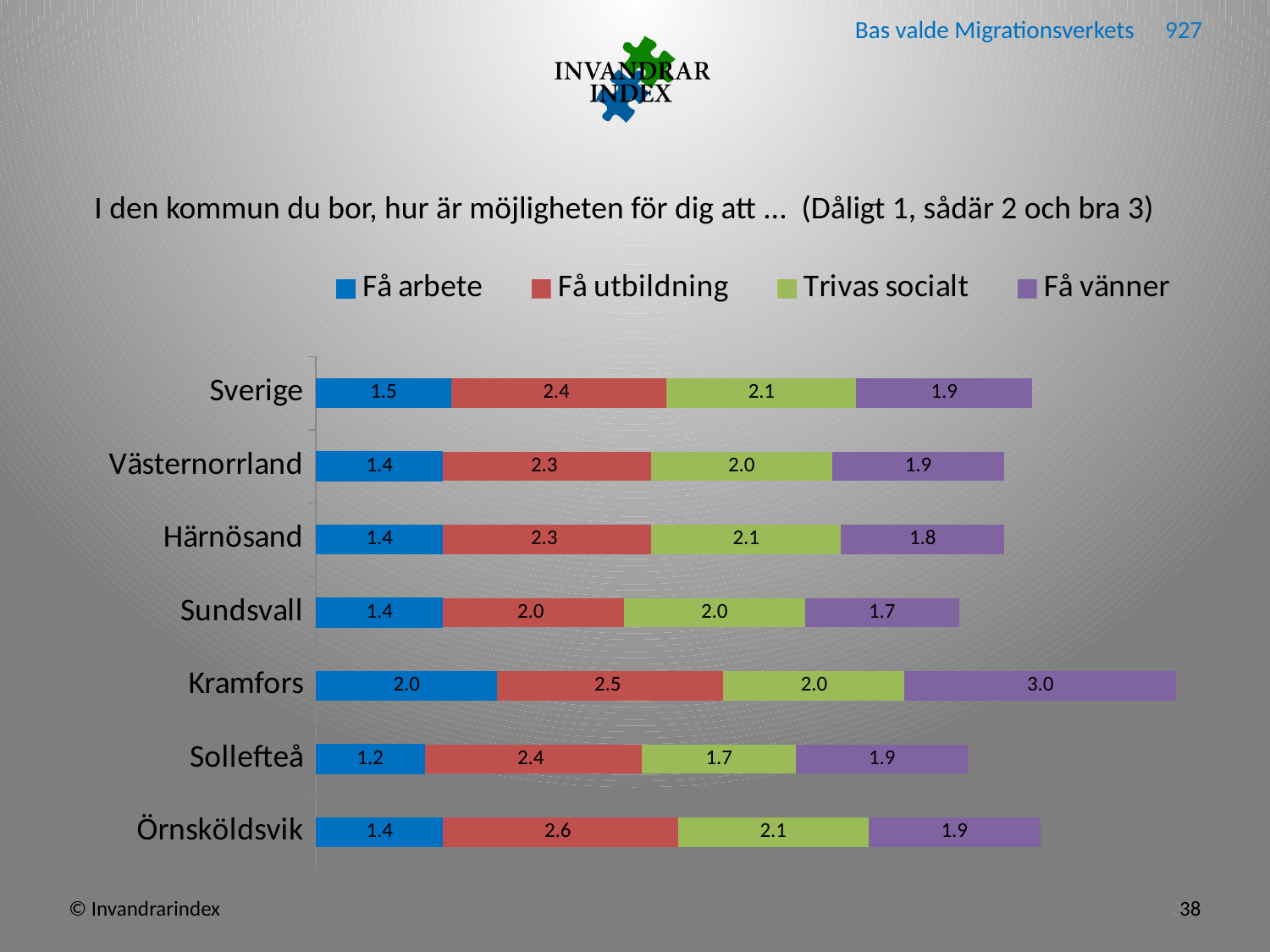
What is the difference between the Få utbildning values for Kramfors and Sundsvall? 0.5 Which category has the highest value for Få vänner? Kramfors What is the total of the stacked bar for Kramfors? 9.5 What is the value for Trivas socialt in Sollefteå? 1.7 What kind of chart is shown on the slide? Stacked bar chart How many series does the legend list? 4 What is the value for Få utbildning in Örnsköldsvik? 2.6 How many categories are shown on the chart? 7 What is the value for Få arbete in Sverige? 1.5 Which category has the lowest value for Få arbete? Sollefteå Which is larger, the Få vänner value for Härnösand or for Sollefteå? Sollefteå What is the value for Få vänner in Kramfors? 3.0